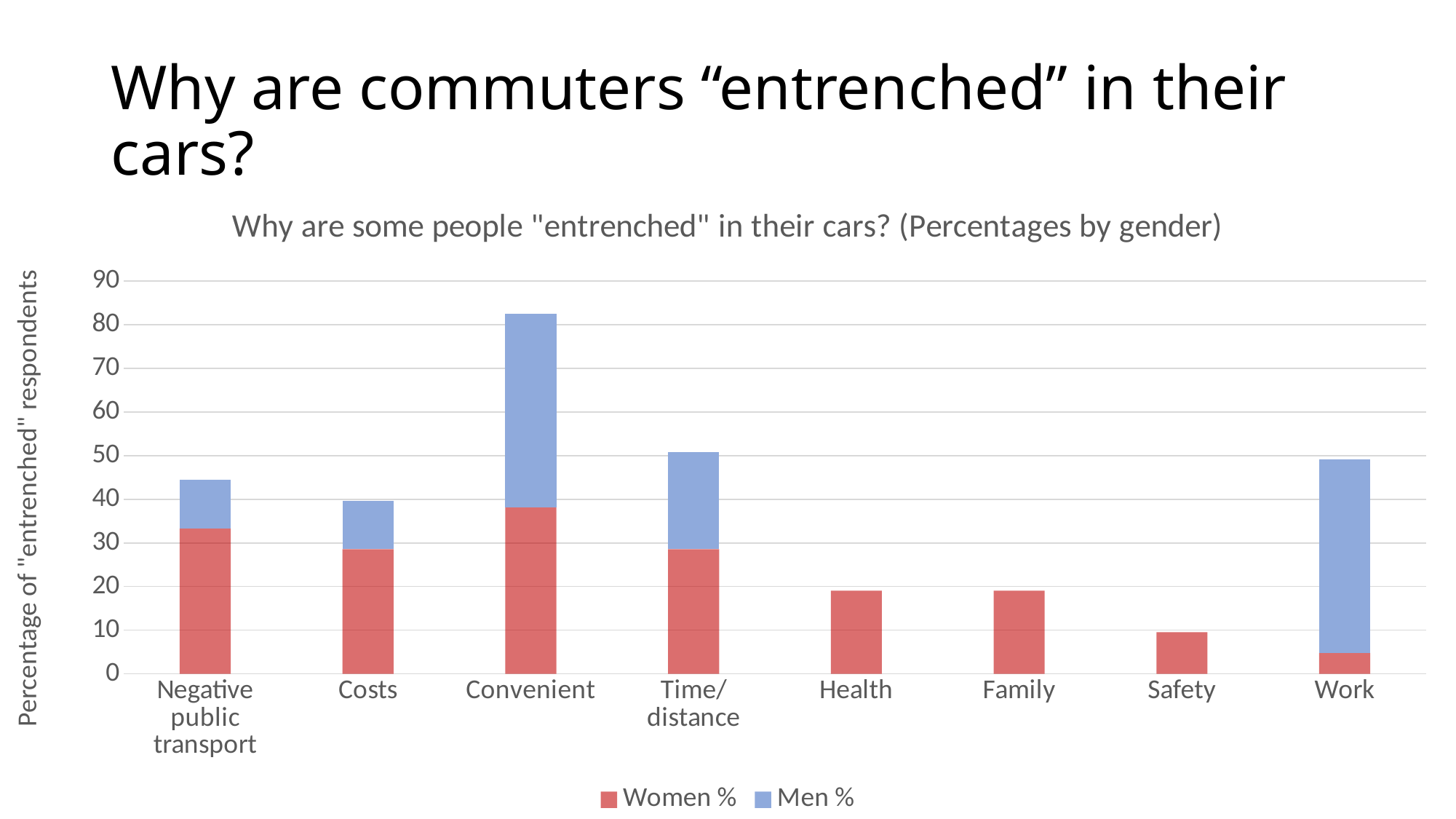
Which category has the highest total bar in the chart? Convenient Is the total bar for Negative public transport greater or less than 40? greater Which category has the lowest total bar in the chart? Safety How many categories are shown on the x axis of the chart? 8 What is the title of the chart? Why are some people "entrenched" in their cars? (Percentages by gender) Which has the larger total bar, Convenient or Time/distance? Convenient Is the total bar for Safety greater or less than 20? less Is the total bar for Work greater or less than 40? greater How many series does the chart legend list? 2 What kind of chart is shown on the slide? Stacked bar chart Which category has the larger Men % segment, Work or Negative public transport? Work